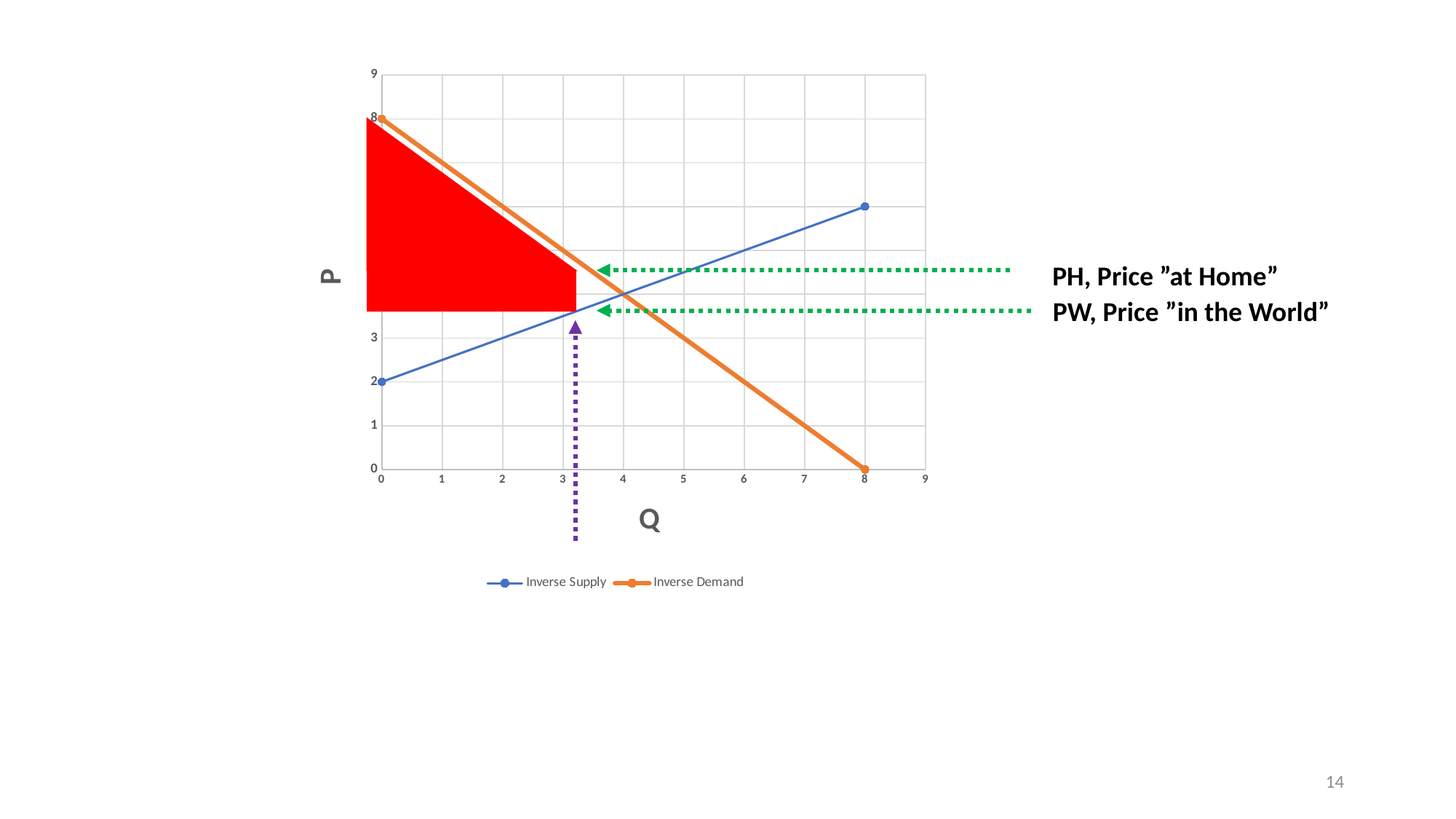
What are the two series named in the legend? Inverse Supply and Inverse Demand What kind of chart is shown on the slide? line chart Is the value of Inverse Supply at Q = 8 greater or less than 3? greater What is the label on the horizontal axis? Q Does the Inverse Demand line rise or fall as Q increases? fall At Q = 8, which series has the higher value, Inverse Supply or Inverse Demand? Inverse Supply What is the value of Inverse Demand at Q = 8? 0 At Q = 0, which series has the higher value, Inverse Supply or Inverse Demand? Inverse Demand How many series does the legend list? 2 What is the value of Inverse Supply at Q = 0? 2 What is the value of Inverse Demand at Q = 0? 8 Does the Inverse Supply line rise or fall as Q increases? rise